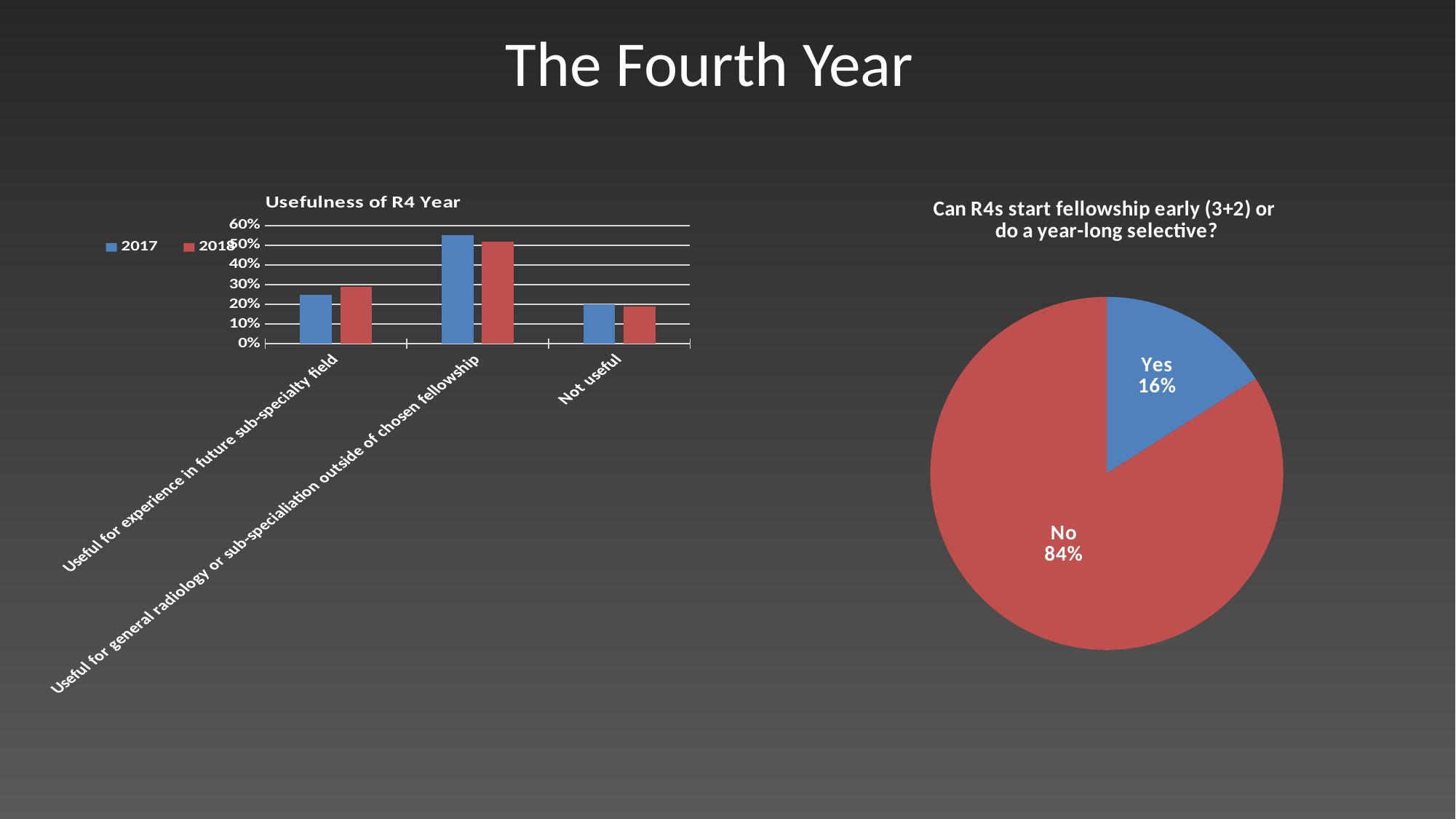
In the 'Usefulness of R4 Year' chart, which category has the highest value for 2017? Useful for general radiology or sub-specialiation outside of chosen fellowship How many categories are shown on the x axis of the 'Usefulness of R4 Year' chart? 3 What kind of chart is the 'Usefulness of R4 Year' chart? bar chart In the 'Usefulness of R4 Year' chart, is the 2017 value for 'Useful for general radiology or sub-specialiation outside of chosen fellowship' greater or less than 50%? greater In the 'Usefulness of R4 Year' chart, which category has the lowest value for 2018? Not useful In the pie chart 'Can R4s start fellowship early (3+2) or do a year-long selective?', what is the difference between the 'No' and 'Yes' shares? 68% What kind of chart is the 'Can R4s start fellowship early (3+2) or do a year-long selective?' chart? pie chart In the 'Usefulness of R4 Year' chart, is the 2018 value for 'Not useful' greater or less than 30%? less How many series does the legend of the 'Usefulness of R4 Year' chart list? 2 In the pie chart 'Can R4s start fellowship early (3+2) or do a year-long selective?', what share of responses is 'No'? 84% In the 'Usefulness of R4 Year' chart, for 'Useful for experience in future sub-specialty field', which series has the larger value, 2017 or 2018? 2018 In the pie chart 'Can R4s start fellowship early (3+2) or do a year-long selective?', what is the value for 'Yes'? 16%